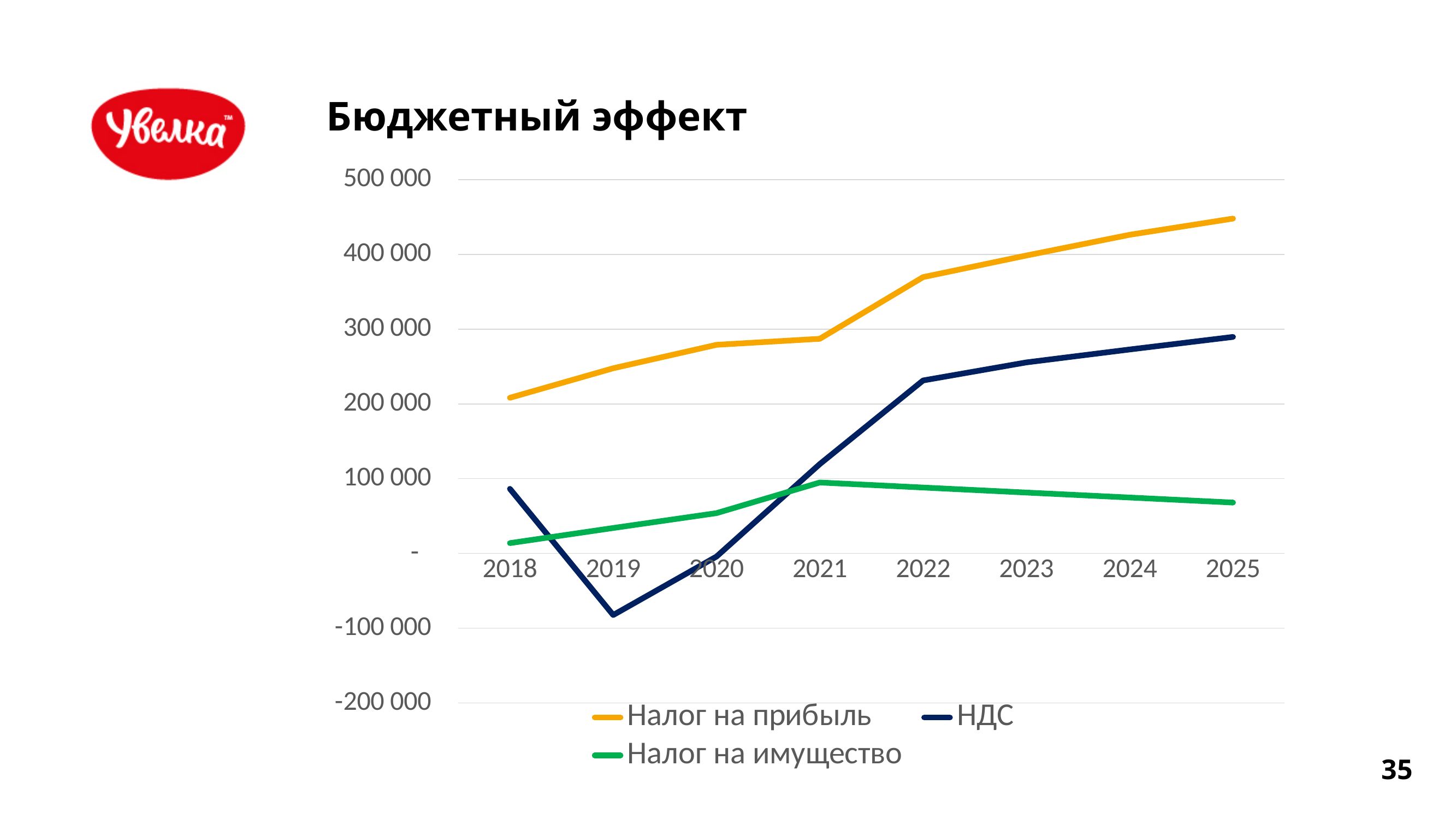
What is the title of the slide? Бюджетный эффект In 2025, which is larger: Налог на прибыль or НДС? Налог на прибыль How many series does the legend list? 3 In 2019, which is larger: НДС or Налог на имущество? Налог на имущество How many years are shown on the x axis? 8 Is the value for Налог на имущество in 2025 greater or less than 100 000? less Which series is drawn in green? Налог на имущество Is the value for Налог на прибыль in 2025 greater or less than 400 000? greater In which year is НДС at its lowest? 2019 Is the value for НДС in 2022 greater or less than 200 000? greater What kind of chart is shown on the slide? line chart